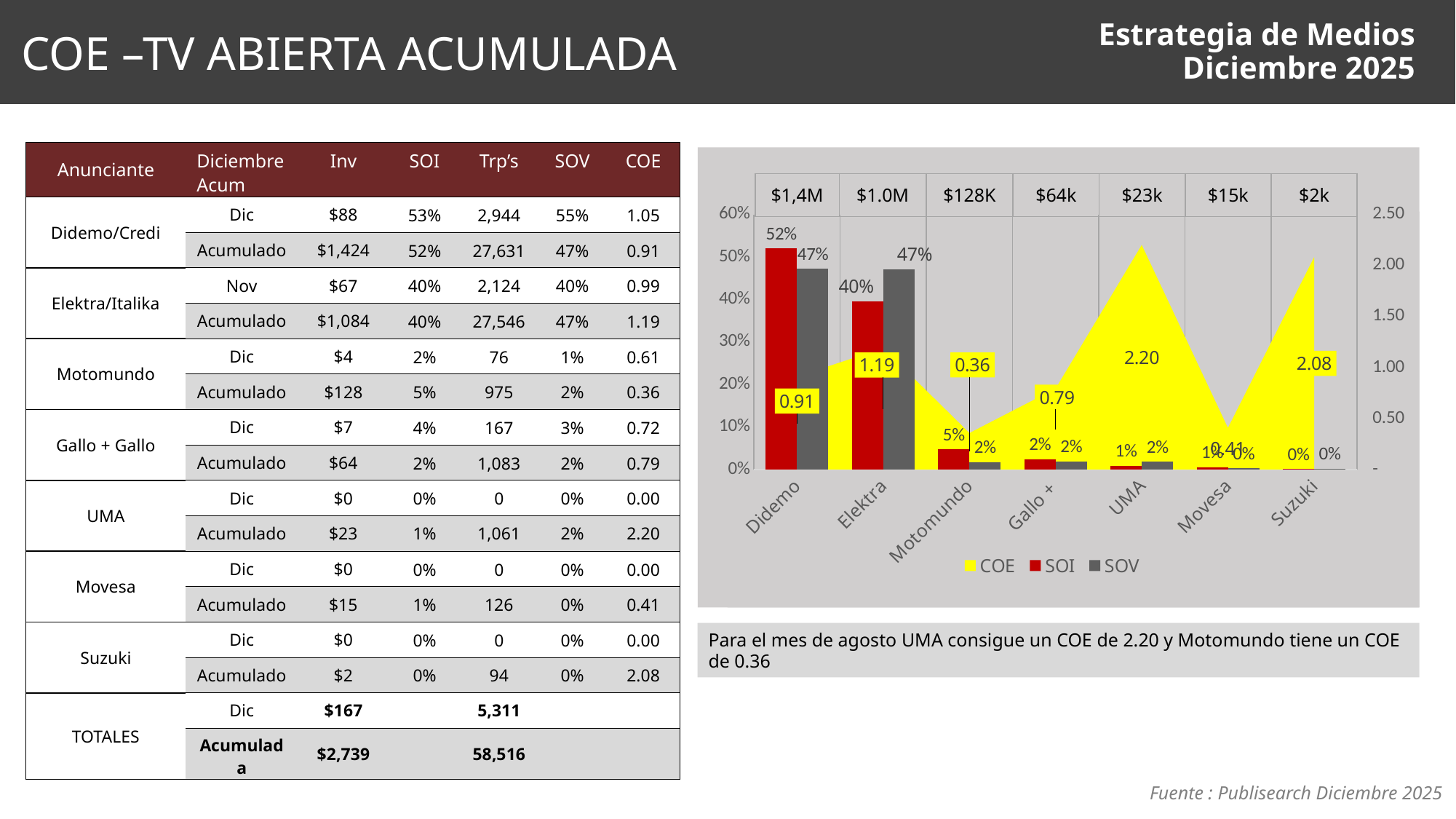
What is the COE value for UMA in the chart? 2.20 What is the SOV value for Elektra in the chart? 47% What is the difference between the SOI values for Didemo and Elektra in the chart? 12% How many series does the chart legend list? 3 Which is larger in the chart, the COE for Elektra or the COE for Gallo +? Elektra How many categories are shown on the x axis of the chart? 7 Is the SOV value for Didemo greater or less than 40%? greater What is the COE value for Motomundo in the chart? 0.36 What is the SOI value for Didemo in the chart? 52% Which category has the highest SOI value in the chart? Didemo Which category has the highest COE value in the chart? UMA Which series in the chart is shown in yellow? COE